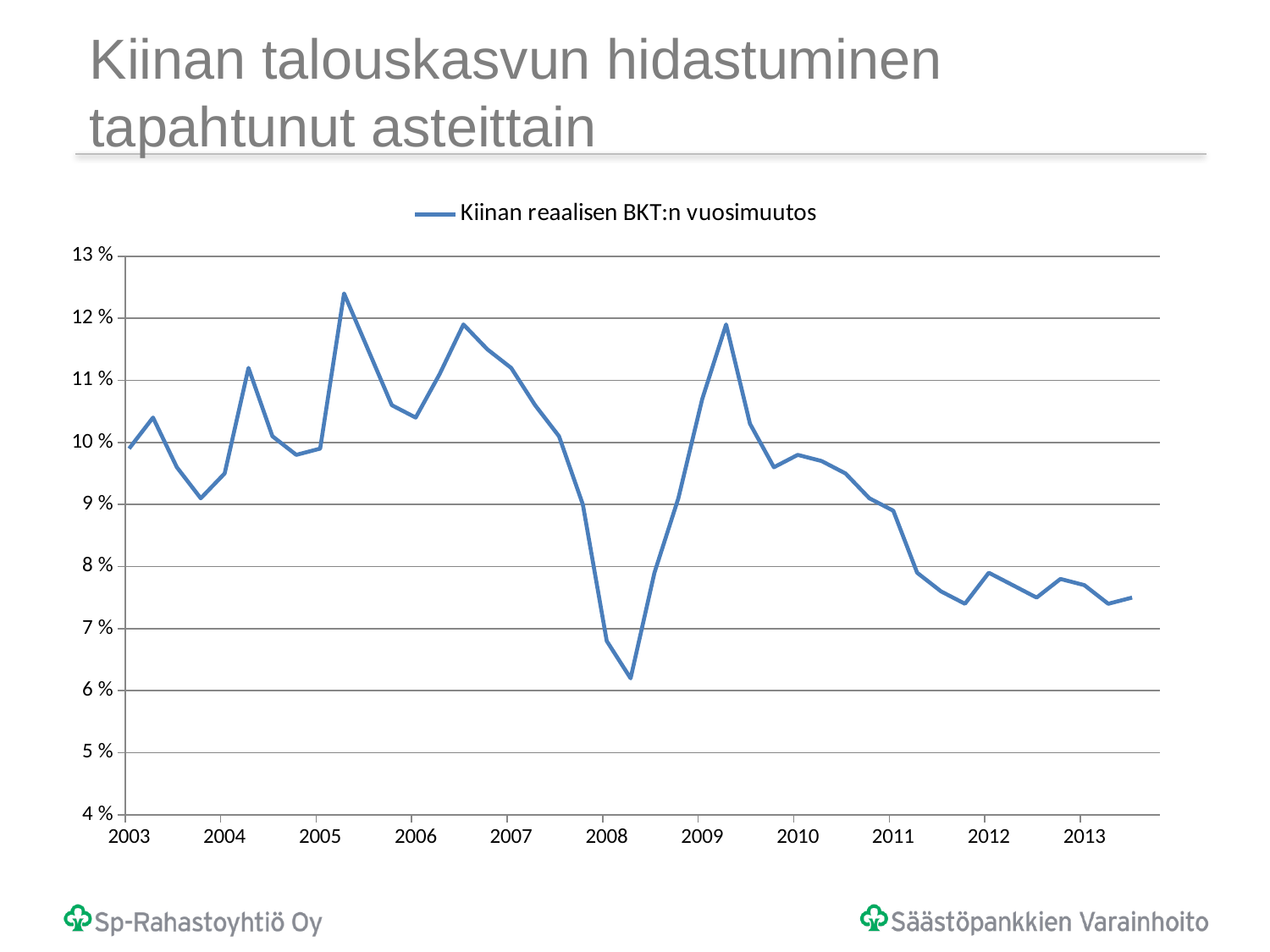
What is the name of the series shown in the legend? Kiinan reaalisen BKT:n vuosimuutos In which year does the line reach its highest point? 2005 What kind of chart is shown on the slide? line chart Is the lowest value of the line, in 2008, greater or less than 7 %? less What is the title of the slide containing the chart? Kiinan talouskasvun hidastuminen tapahtunut asteittain Is the value at the start of the line in 2003 greater or less than 9 %? greater Is the value at the end of the line in 2013 greater or less than 8 %? less How many series does the legend list? 1 Does the line generally rise or fall from 2009 to 2013? fall How many year labels are shown on the x axis? 11 In which year does the line reach its lowest point? 2008